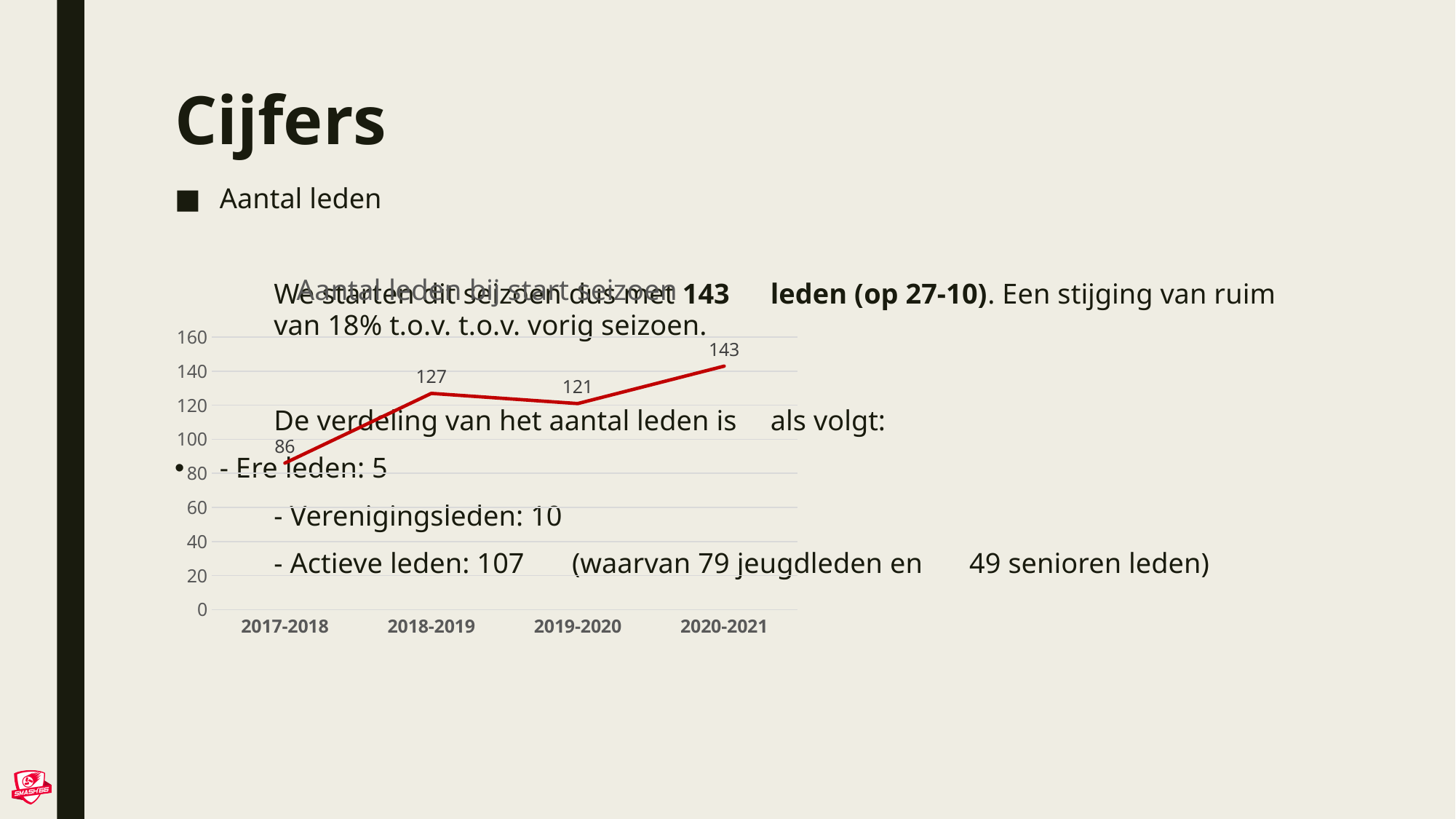
Which season has the lowest value? 2017-2018 What is the difference between the values for 2020-2021 and 2017-2018? 57 What is the value for 2020-2021? 143 What is the difference between the values for 2018-2019 and 2019-2020? 6 What is the value for 2019-2020? 121 What kind of chart is shown on the slide? line chart What is the value for 2018-2019? 127 Is the value for 2017-2018 greater or less than 100? less How many seasons are plotted on the chart? 4 Which is larger, the value for 2018-2019 or the value for 2019-2020? 2018-2019 Which season has the highest value? 2020-2021 What is the value for 2017-2018? 86